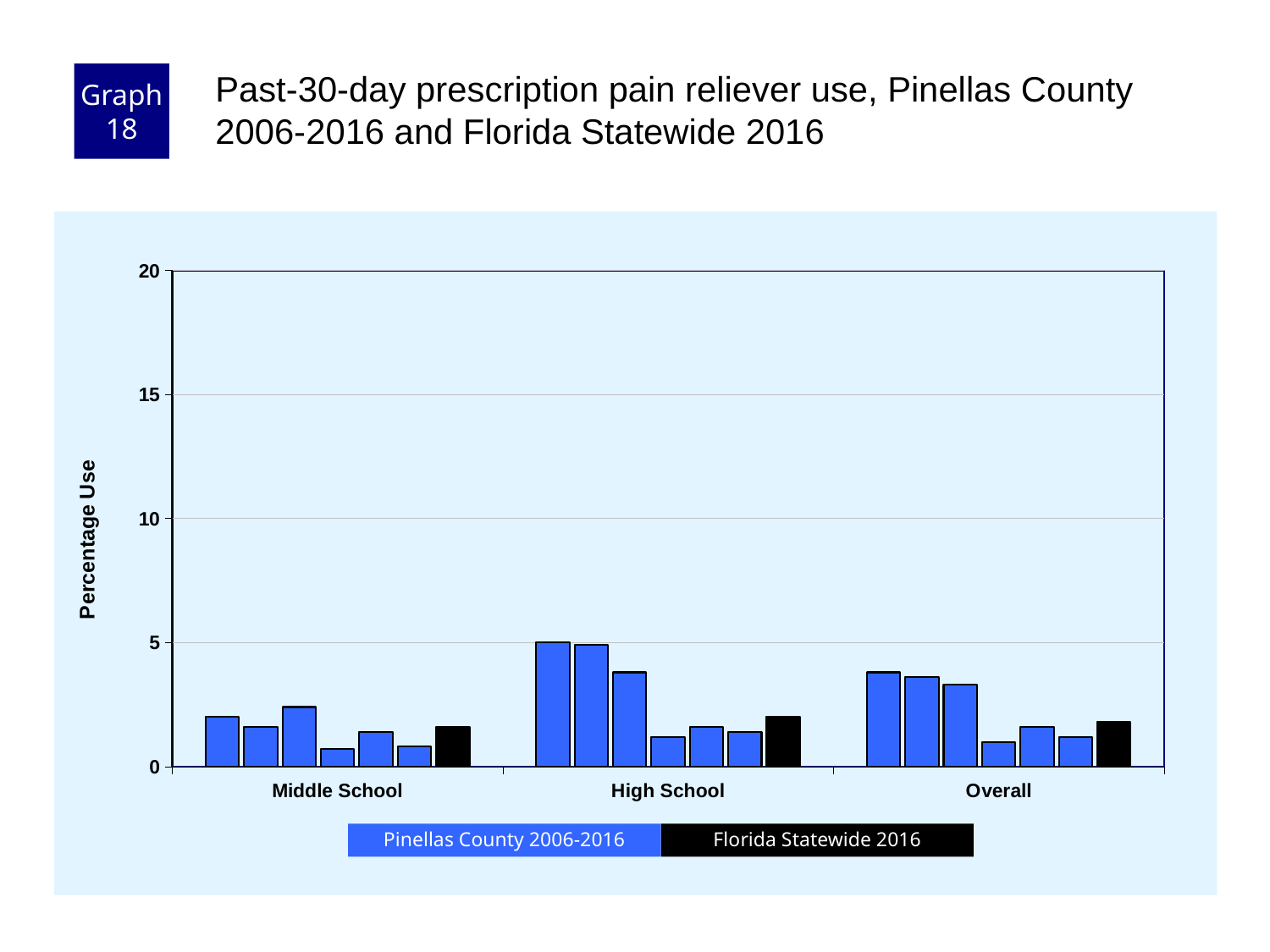
How many series does the legend list? 2 Is the Florida Statewide 2016 value for High School greater or less than 5? less Is the Florida Statewide 2016 value for Overall greater or less than 5? less Which is larger, the Florida Statewide 2016 bar for High School or the Florida Statewide 2016 bar for Middle School? High School How many school-level categories are shown on the x axis? 3 What is the highest value shown on the y axis? 20 Is the Florida Statewide 2016 value for Middle School greater or less than 5? less What is the label on the y axis? Percentage Use What kind of chart is shown on the slide? bar chart What colour are the Florida Statewide 2016 bars? black Which category contains the tallest bar in the chart? High School